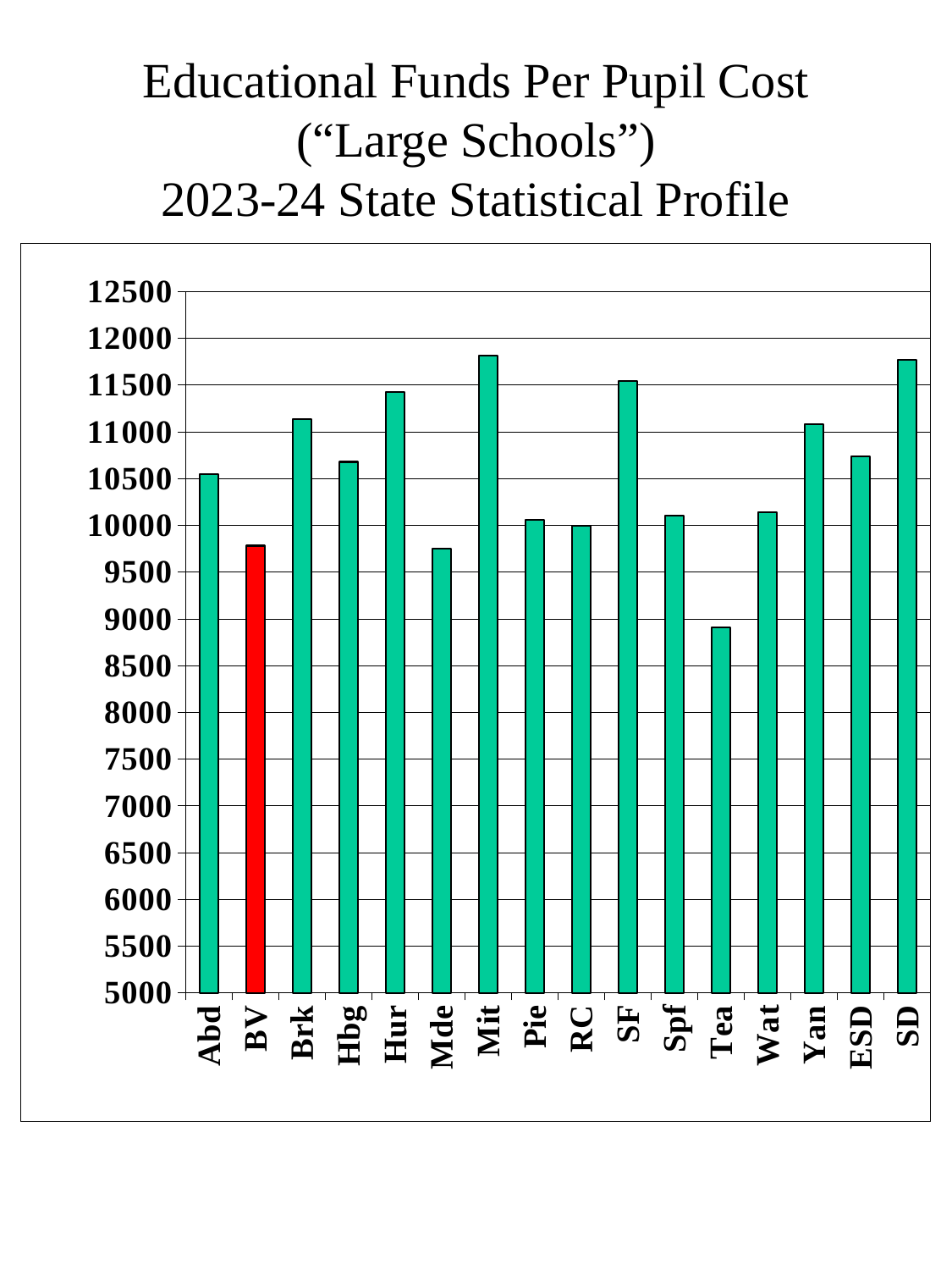
Is the value for BV greater or less than 10000? less Which bar is coloured red rather than green? BV Is the value for Mde greater or less than 10000? less Which school has the lowest educational funds per pupil cost? Tea What kind of chart is shown on the slide? bar chart Is the value for Mit greater or less than 11500? greater How many schools (categories) are shown on the x axis? 16 Which has the larger per pupil cost, Abd or BV? Abd Which has the larger per pupil cost, Hur or Yan? Hur What is the title of the chart? Educational Funds Per Pupil Cost ("Large Schools") 2023-24 State Statistical Profile